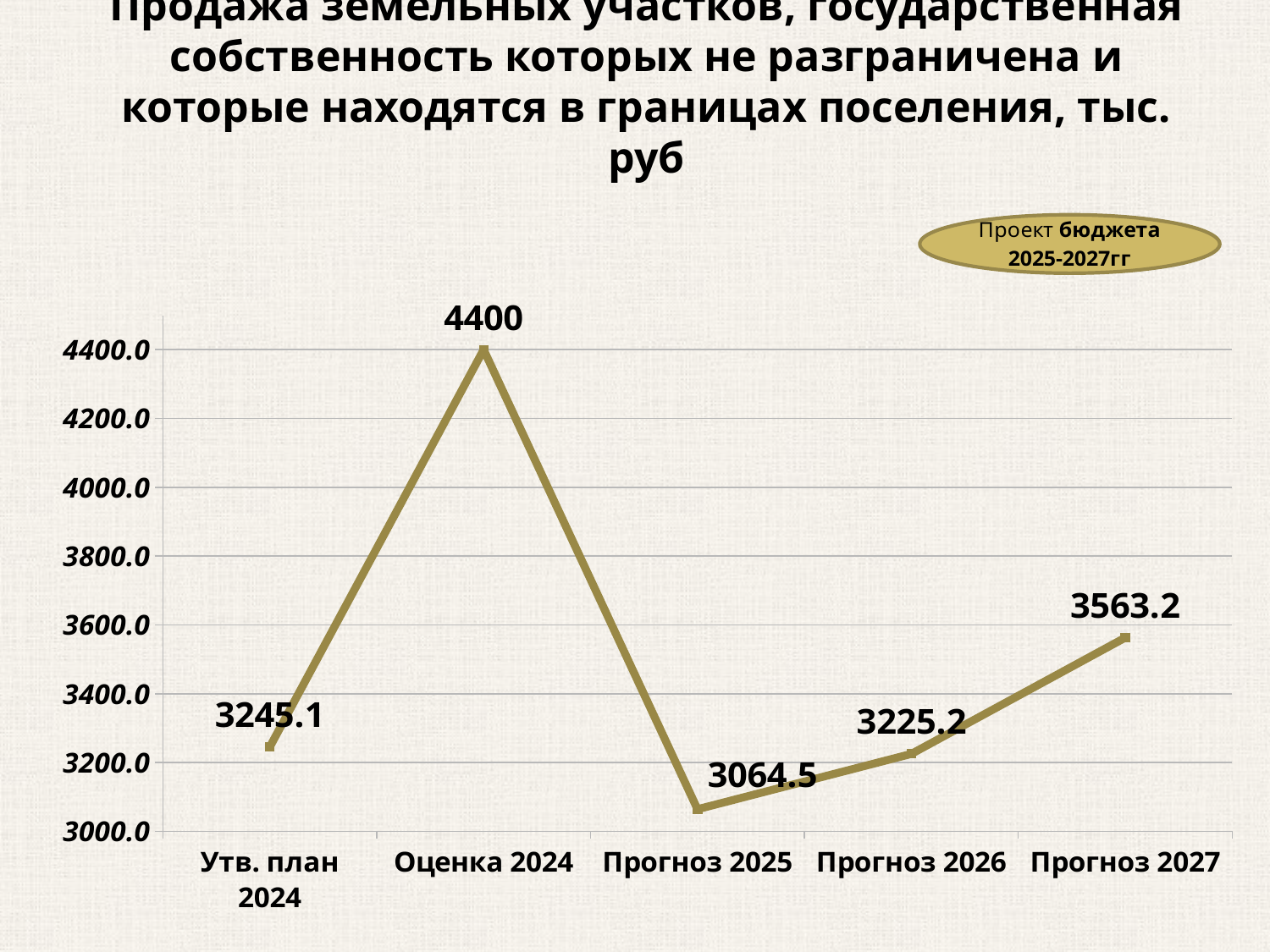
How many categories are plotted on the x axis? 5 What is the difference between the values for Прогноз 2027 and Прогноз 2026? 338 What is the value for Утв. план 2024? 3245.1 Which category has the highest value? Оценка 2024 What is the value for Оценка 2024? 4400 Which is larger, the value for Прогноз 2027 or the value for Утв. план 2024? Прогноз 2027 Do the values rise or fall from Прогноз 2025 to Прогноз 2027? Rise What is the value for Прогноз 2025? 3064.5 What is the value for Прогноз 2027? 3563.2 What is the difference between the values for Оценка 2024 and Прогноз 2025? 1335.5 Which category has the lowest value? Прогноз 2025 What kind of chart is shown on the slide? Line chart